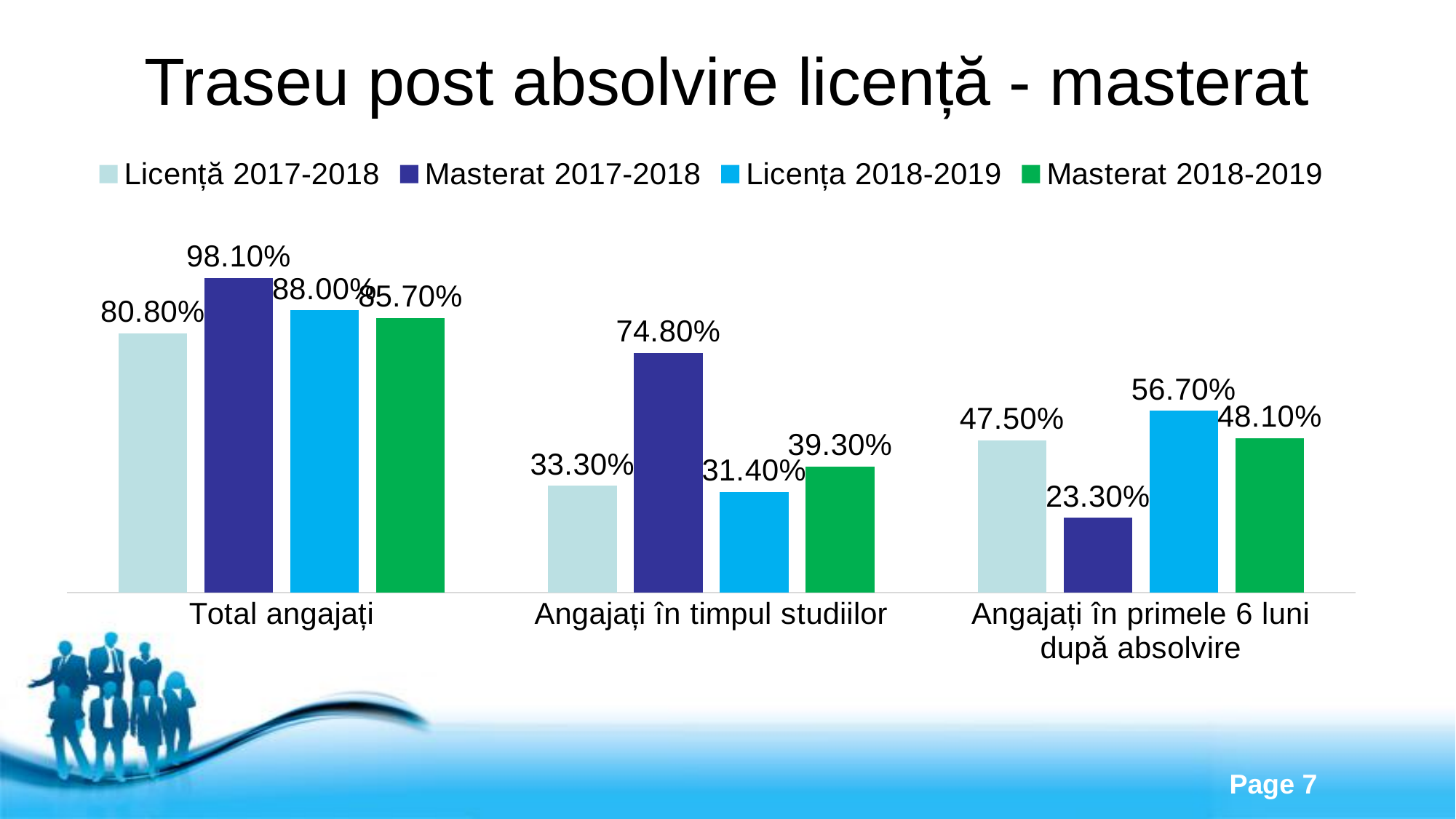
What is the title of the slide? Traseu post absolvire licență - masterat What is the difference between Licența 2018-2019 and Masterat 2017-2018 in the Angajați în primele 6 luni după absolvire category? 33.40% What is the value for Masterat 2017-2018 in the Total angajați category? 98.10% What is the difference between Masterat 2017-2018 and Licență 2017-2018 in the Total angajați category? 17.30% How many categories are shown on the x axis? 3 What type of chart is shown on the slide? bar chart How many series does the legend list? 4 What is the value for Licență 2017-2018 in the Angajați în timpul studiilor category? 33.30% Which series has the lowest value in the Angajați în primele 6 luni după absolvire category? Masterat 2017-2018 What is the value for Licența 2018-2019 in the Angajați în primele 6 luni după absolvire category? 56.70% Which is larger in the Angajați în timpul studiilor category: Masterat 2018-2019 or Licența 2018-2019? Masterat 2018-2019 Which series has the highest value in the Angajați în timpul studiilor category? Masterat 2017-2018